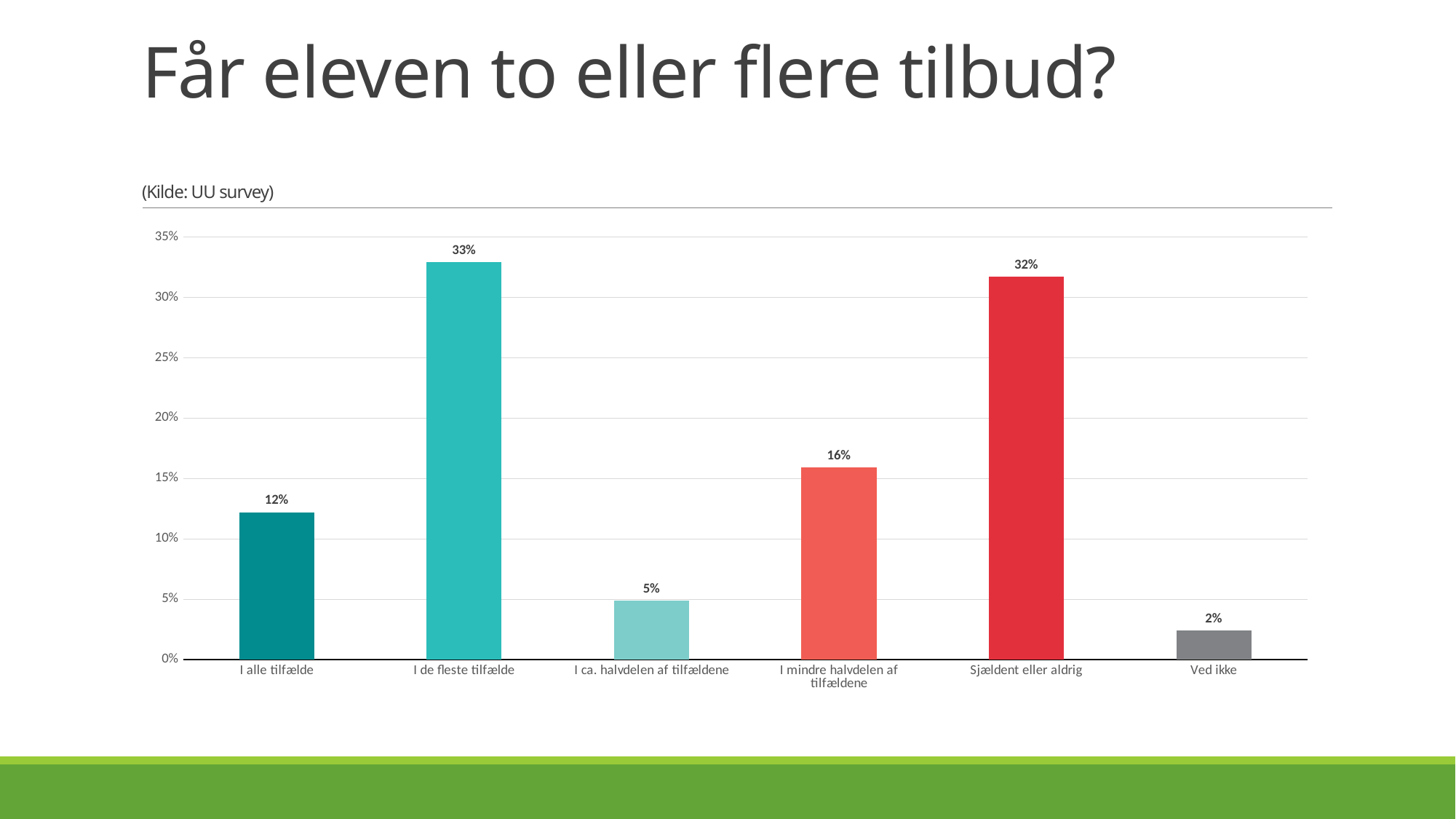
Is the value for "Sjældent eller aldrig" greater or less than 30%? greater What is the value for "Sjældent eller aldrig"? 32% Which is larger, the value for "I mindre halvdelen af tilfældene" or the value for "I alle tilfælde"? I mindre halvdelen af tilfældene What is the value for "Ved ikke"? 2% What is the difference between the values for "I de fleste tilfælde" and "I alle tilfælde"? 21% What source is cited above the chart? UU survey What is the value for "I de fleste tilfælde"? 33% How many categories are shown on the x axis? 6 Which category has the highest value? I de fleste tilfælde Which category has the lowest value? Ved ikke What is the value for "I ca. halvdelen af tilfældene"? 5% What kind of chart is shown on the slide? bar chart